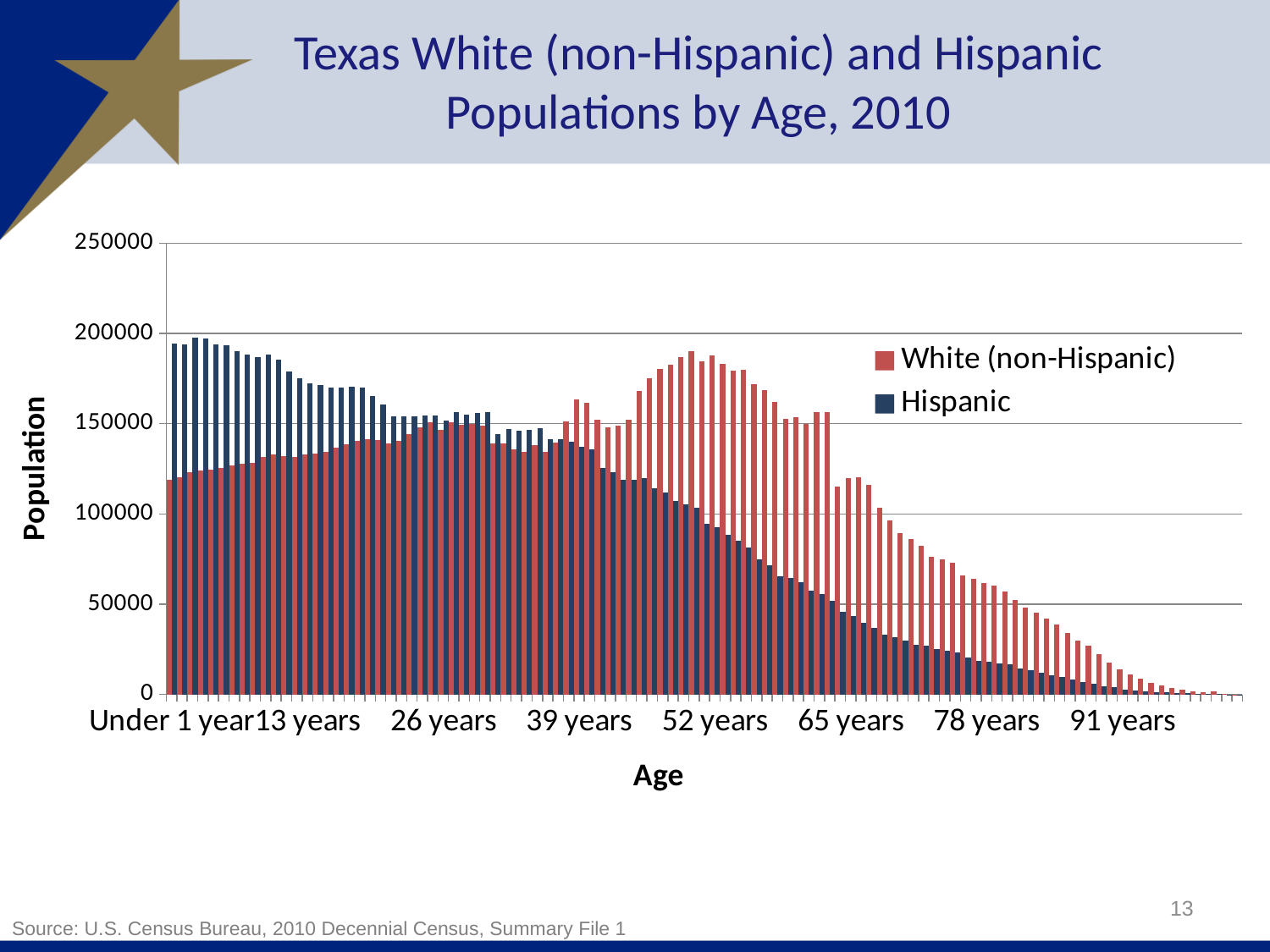
Is the White (non-Hispanic) population at 52 years greater or less than 150000? greater Which series is shown in red? White (non-Hispanic) Is the Hispanic population for Under 1 year greater or less than 150000? greater What is the title of the chart? Texas White (non-Hispanic) and Hispanic Populations by Age, 2010 From 52 years to 91 years, do the White (non-Hispanic) values rise or fall along the x axis? fall Is the Hispanic population at 78 years greater or less than 50000? less At Under 1 year, which is larger: the Hispanic population or the White (non-Hispanic) population? Hispanic How many series does the legend list? 2 What kind of chart is shown on the slide? Bar chart At 52 years, which is larger: the White (non-Hispanic) population or the Hispanic population? White (non-Hispanic)